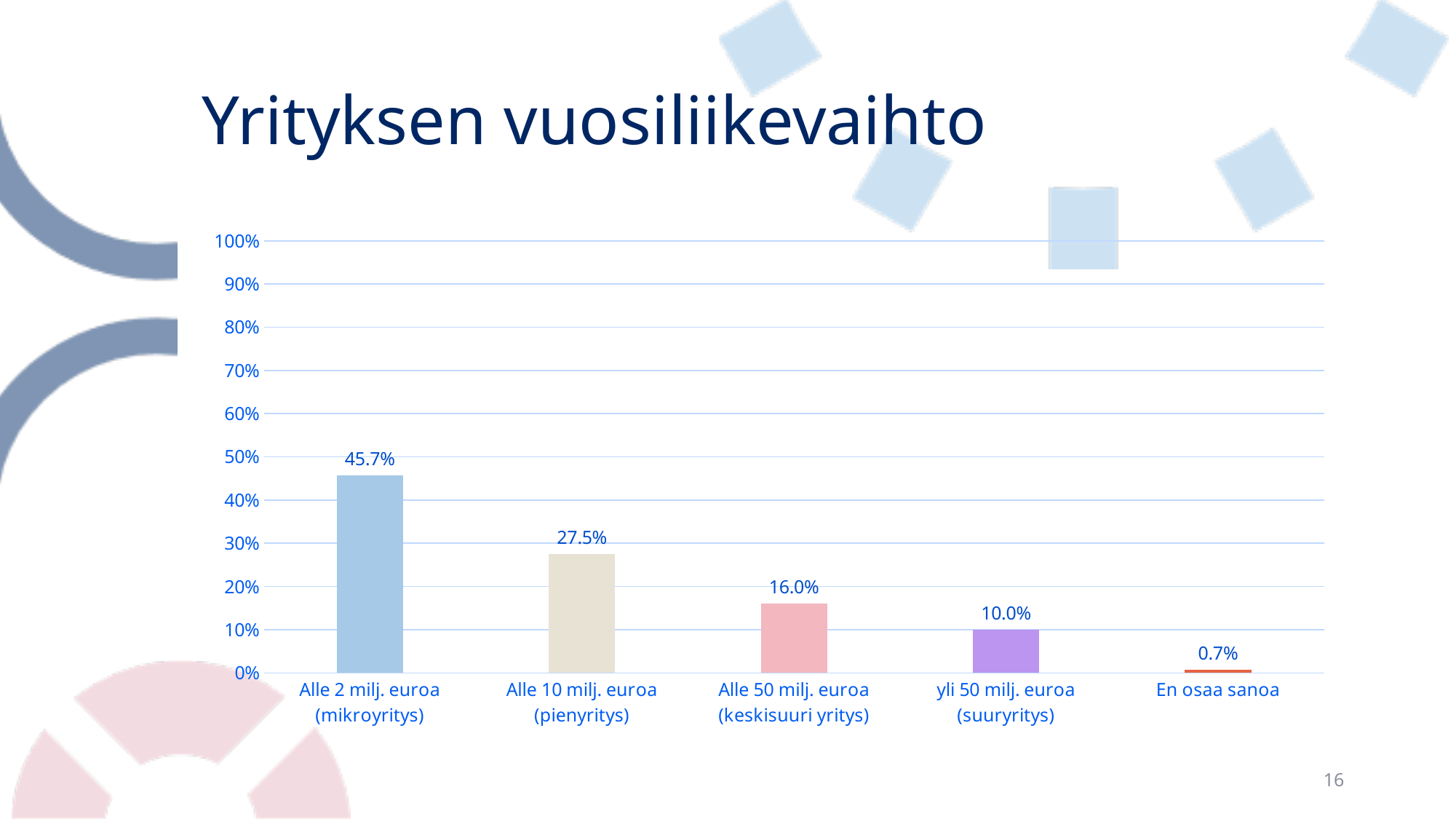
Do the values rise or fall from left to right along the x axis? fall What is the value for "En osaa sanoa"? 0.7% Is the value for "Alle 10 milj. euroa (pienyritys)" greater or less than 30%? less Which category has the highest value? Alle 2 milj. euroa (mikroyritys) Which is larger: the value for "Alle 50 milj. euroa (keskisuuri yritys)" or "yli 50 milj. euroa (suuryritys)"? Alle 50 milj. euroa (keskisuuri yritys) What kind of chart is shown on the slide? bar chart How many categories are shown on the x axis? 5 What is the value for "Alle 2 milj. euroa (mikroyritys)"? 45.7% What is the value for "Alle 10 milj. euroa (pienyritys)"? 27.5% Which category has the lowest value? En osaa sanoa What is the difference between the values for "Alle 2 milj. euroa (mikroyritys)" and "Alle 10 milj. euroa (pienyritys)"? 18.2% What is the title of the slide? Yrityksen vuosiliikevaihto